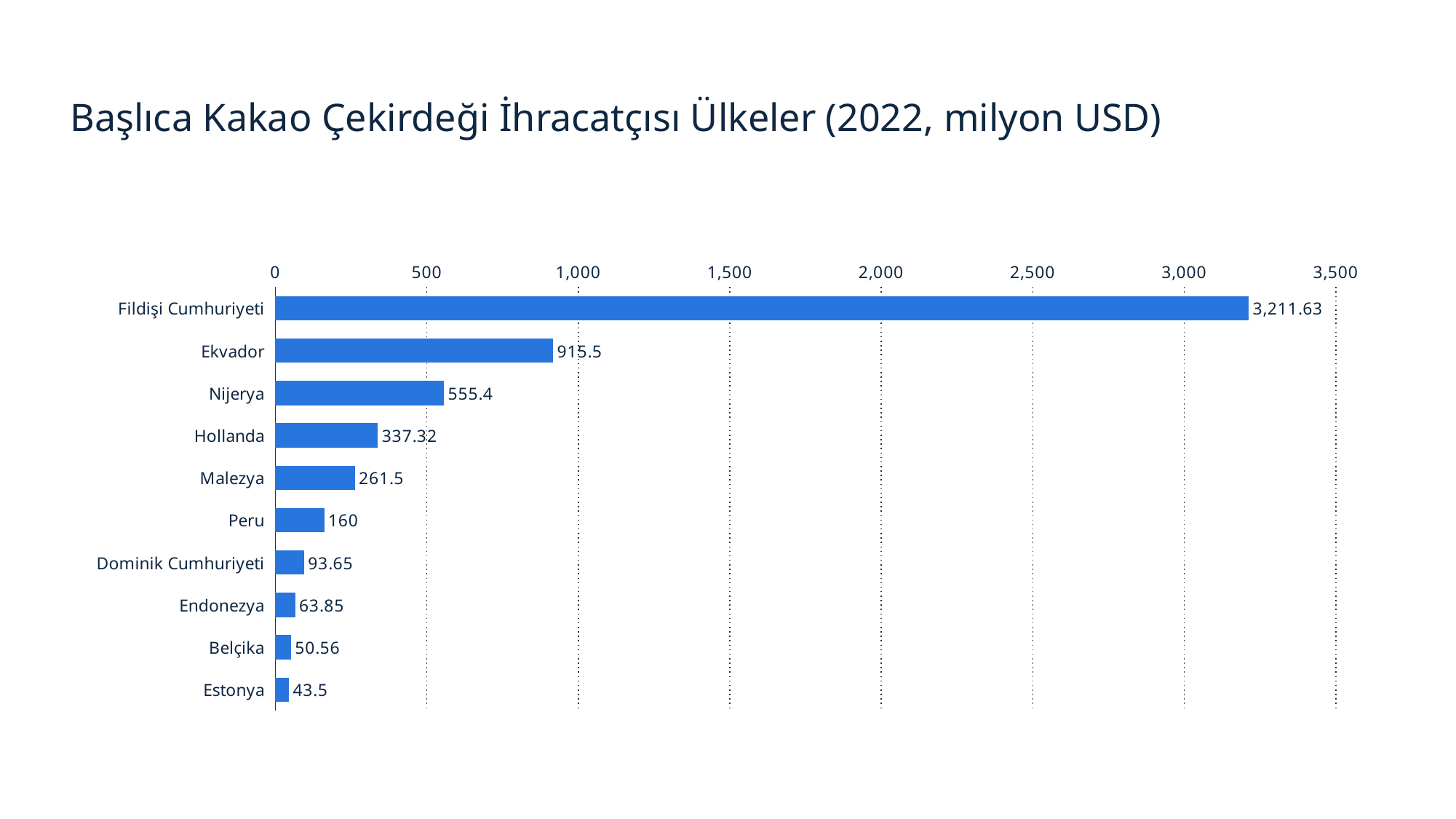
How many countries are shown in the chart? 10 What is the title of the chart? Başlıca Kakao Çekirdeği İhracatçısı Ülkeler (2022, milyon USD) Which is larger, the value for Endonezya or the value for Belçika? Endonezya What is the value for Ekvador? 915.5 Is the value for Fildişi Cumhuriyeti greater or less than 3,000? greater What is the difference between the values for Peru and Malezya? 101.5 Which country has the highest value? Fildişi Cumhuriyeti What is the difference between the values for Ekvador and Nijerya? 360.1 Which country has the lowest value? Estonya What kind of chart is shown on the slide? Bar chart What is the value for Dominik Cumhuriyeti? 93.65 What is the value for Hollanda? 337.32